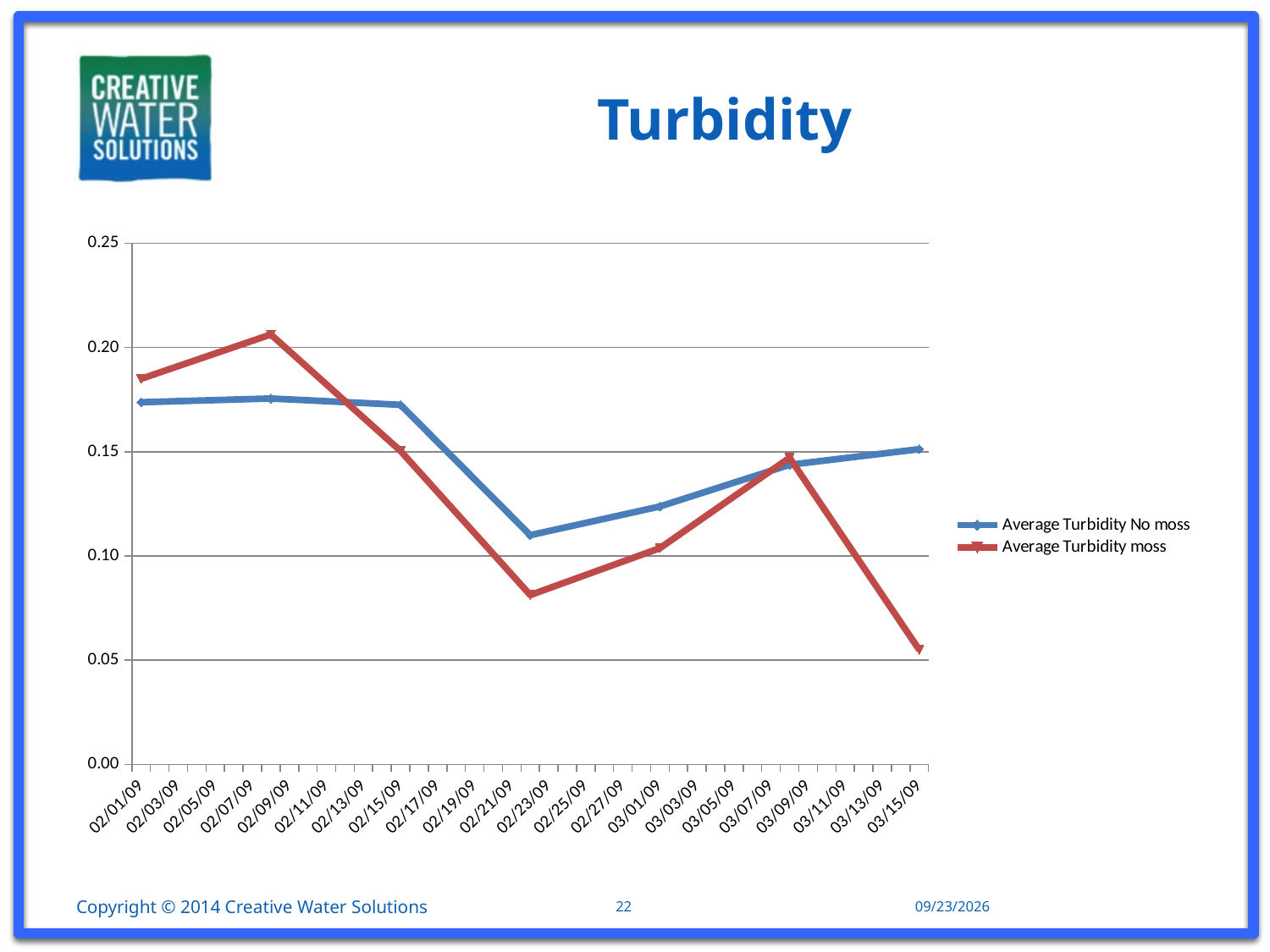
How many data points are plotted for the Average Turbidity moss series? 7 Which colour is used for the Average Turbidity moss series? Red Does the Average Turbidity moss series rise or fall between 03/09/09 and 03/15/09? Fall On 02/23/09, which series has the higher value, Average Turbidity No moss or Average Turbidity moss? Average Turbidity No moss What is the title of the chart? Turbidity On which date does the Average Turbidity moss series reach its lowest value? 03/15/09 How many series does the legend list? 2 Is the value for Average Turbidity No moss on 02/01/09 greater or less than 0.15? greater What kind of chart is shown on the slide? Line chart Is the value for Average Turbidity moss on 03/15/09 greater or less than 0.10? less